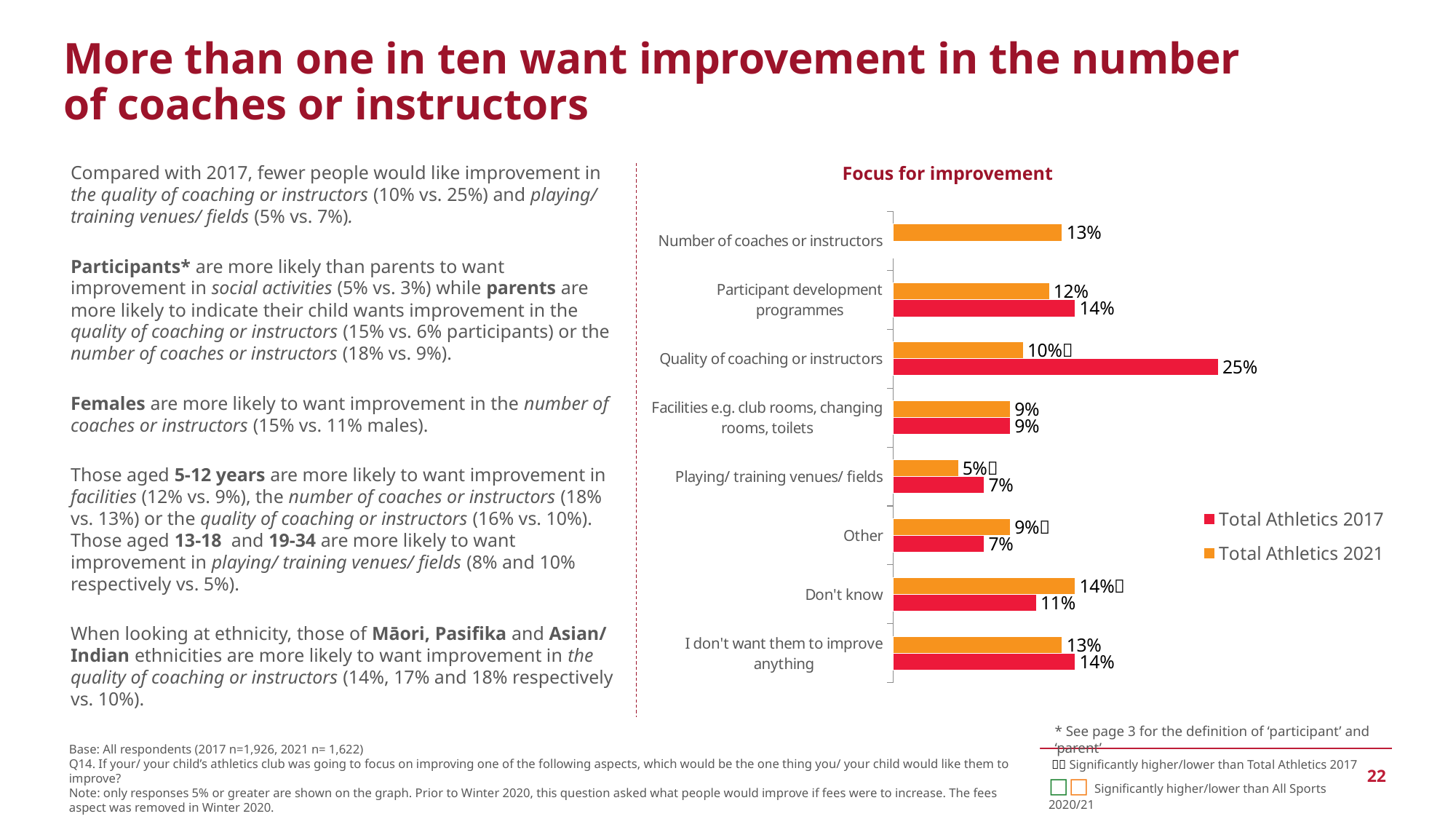
Which category has the lowest Total Athletics 2021 value? Playing/ training venues/ fields What is the difference between the Total Athletics 2017 and Total Athletics 2021 values for 'Quality of coaching or instructors'? 15% What is the Total Athletics 2017 value for 'Other'? 7% What kind of chart is shown under the title 'Focus for improvement'? Bar chart What is the Total Athletics 2021 value for 'Number of coaches or instructors'? 13% How many categories are shown on the 'Focus for improvement' chart? 8 What is the Total Athletics 2021 value for 'Playing/ training venues/ fields'? 5% What is the Total Athletics 2017 value for 'Quality of coaching or instructors'? 25% Which category has the highest Total Athletics 2017 value? Quality of coaching or instructors How many series does the legend of the 'Focus for improvement' chart list? 2 Which colour represents Total Athletics 2021 in the chart? Orange For 'Don't know', which is larger: the Total Athletics 2017 value or the Total Athletics 2021 value? Total Athletics 2021